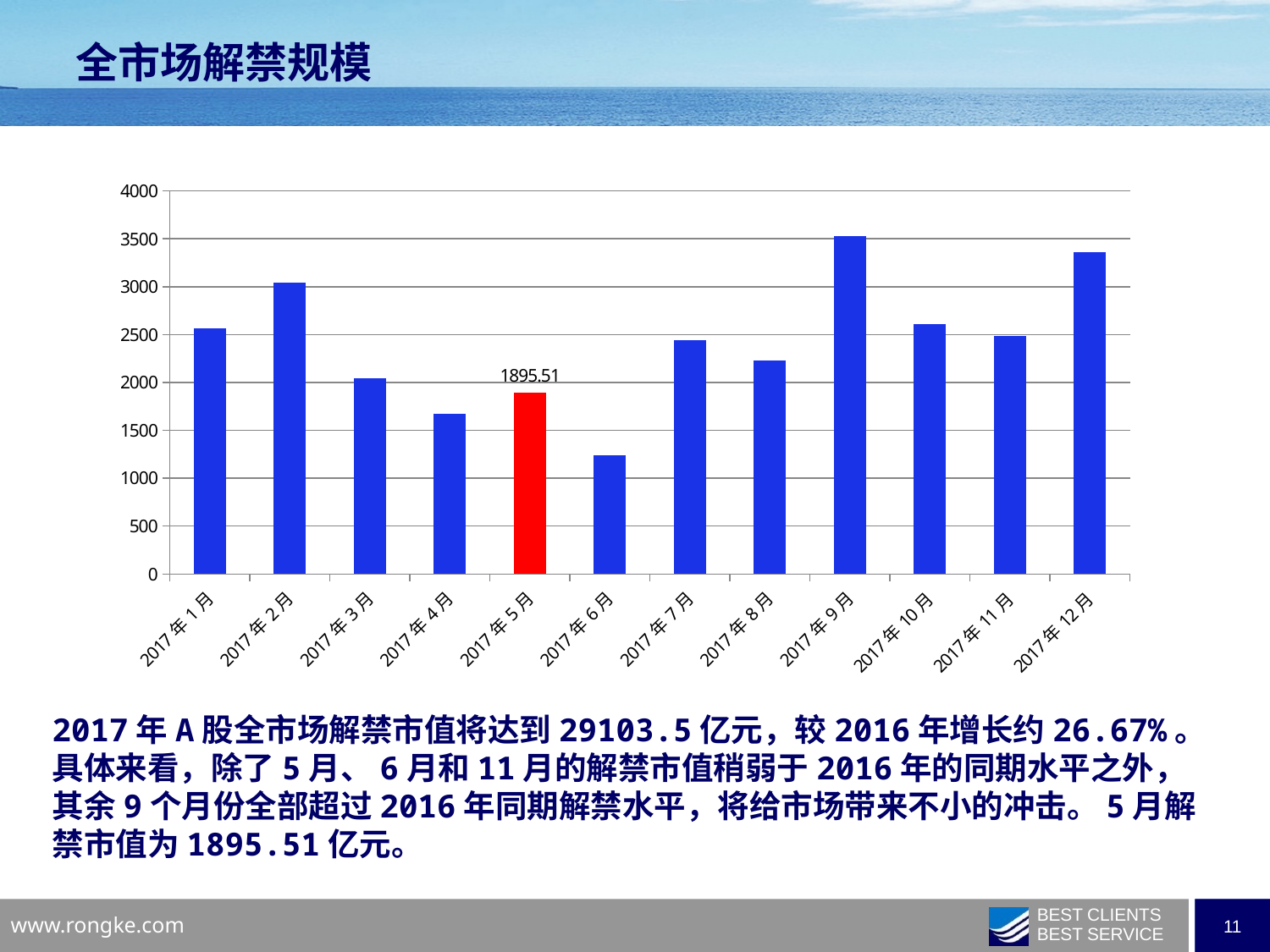
Is the value for 2017年8月 greater or less than 2000? greater What kind of chart is shown on the slide? bar chart Is the value for 2017年4月 greater or less than 2000? less How many months are plotted on the x axis? 12 Which month has the highest bar? 2017年9月 Which month has the lowest bar? 2017年6月 What colour is the bar for 2017年5月? red Is the value for 2017年12月 greater or less than 3000? greater Which is larger, the value for 2017年3月 or 2017年4月? 2017年3月 Which is larger, the value for 2017年2月 or 2017年12月? 2017年12月 What is the value shown for 2017年5月? 1895.51